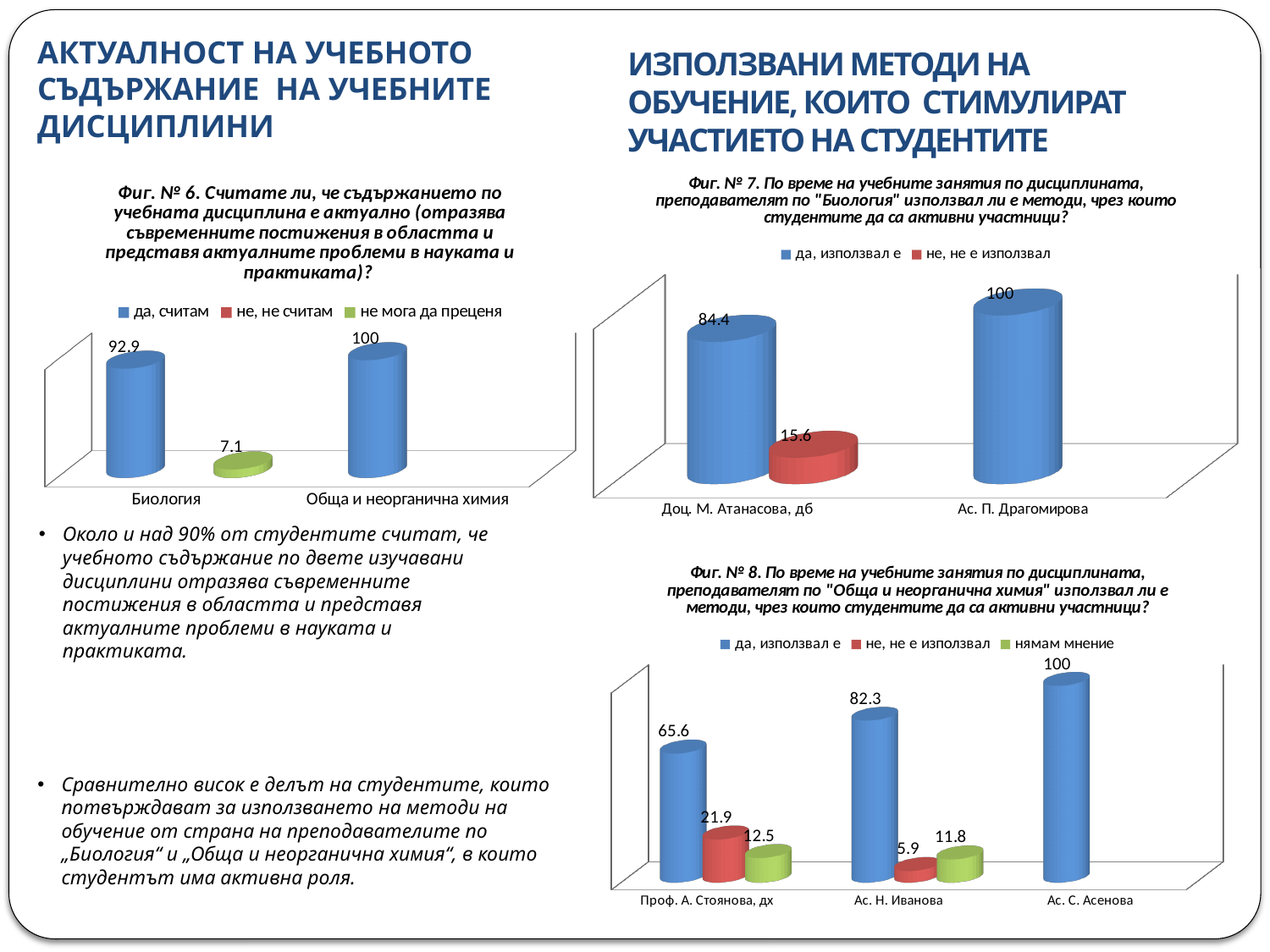
In the chart for Фиг. № 7, what is the value of "не, не е използвал" for Доц. М. Атанасова, дб? 15.6 In the chart for Фиг. № 7, how many categories are shown on the x axis? 2 In the chart for Фиг. № 6, what is the value of "да, считам" for Биология? 92.9 In the chart for Фиг. № 8, what is the value of "да, използвал е" for Ас. Н. Иванова? 82.3 In the chart for Фиг. № 8, which is larger for Проф. А. Стоянова, дх: "не, не е използвал" or "нямам мнение"? не, не е използвал In the chart for Фиг. № 6, what is the value of "не мога да преценя" for Биология? 7.1 In the chart for Фиг. № 8, what colour represents "нямам мнение"? green In the chart for Фиг. № 8, what is the difference between the "не, не е използвал" values for Проф. А. Стоянова, дх and Ас. Н. Иванова? 16 In the chart for Фиг. № 8, what kind of chart is shown? bar chart In the chart for Фиг. № 8, which category has the lowest "да, използвал е" value? Проф. А. Стоянова, дх In the chart for Фиг. № 6, how many series does the legend list? 3 In the chart for Фиг. № 7, what is the difference between the "да, използвал е" values for Ас. П. Драгомирова and Доц. М. Атанасова, дб? 15.6